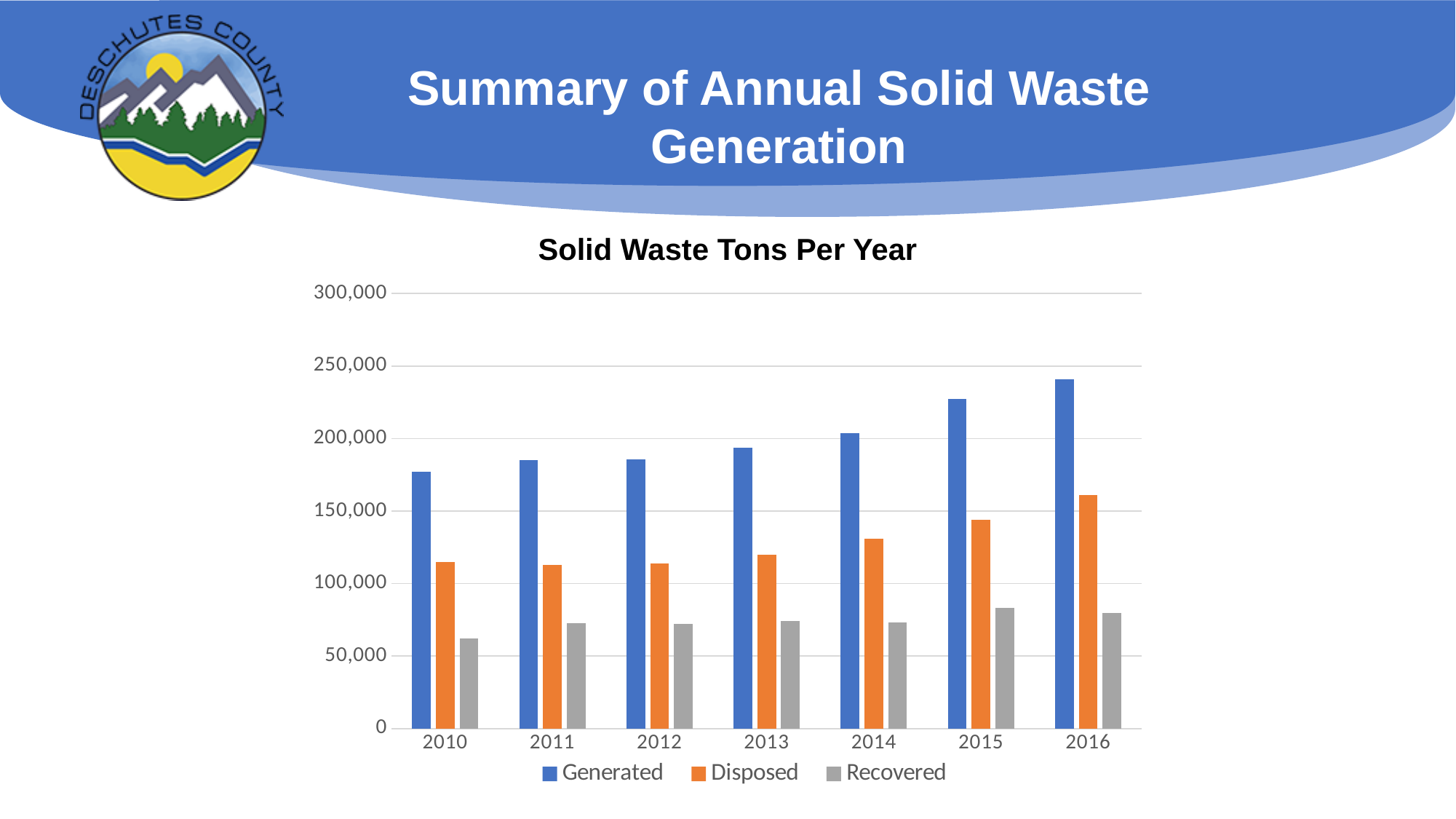
What type of chart is shown on the slide? Bar chart How many series does the legend list? 3 Which year has the highest Disposed value? 2016 Is the Generated value for 2016 greater or less than 200,000? greater Is the Disposed value for 2016 greater or less than 150,000? greater Does the Generated series rise or fall from 2010 to 2016? Rise How many years are shown on the x axis? 7 Is the Recovered value for 2013 greater or less than 100,000? less Which year has the lowest Generated value? 2010 Which year has the highest Generated value? 2016 Which year has the lowest Recovered value? 2010 What is the title of the chart? Solid Waste Tons Per Year